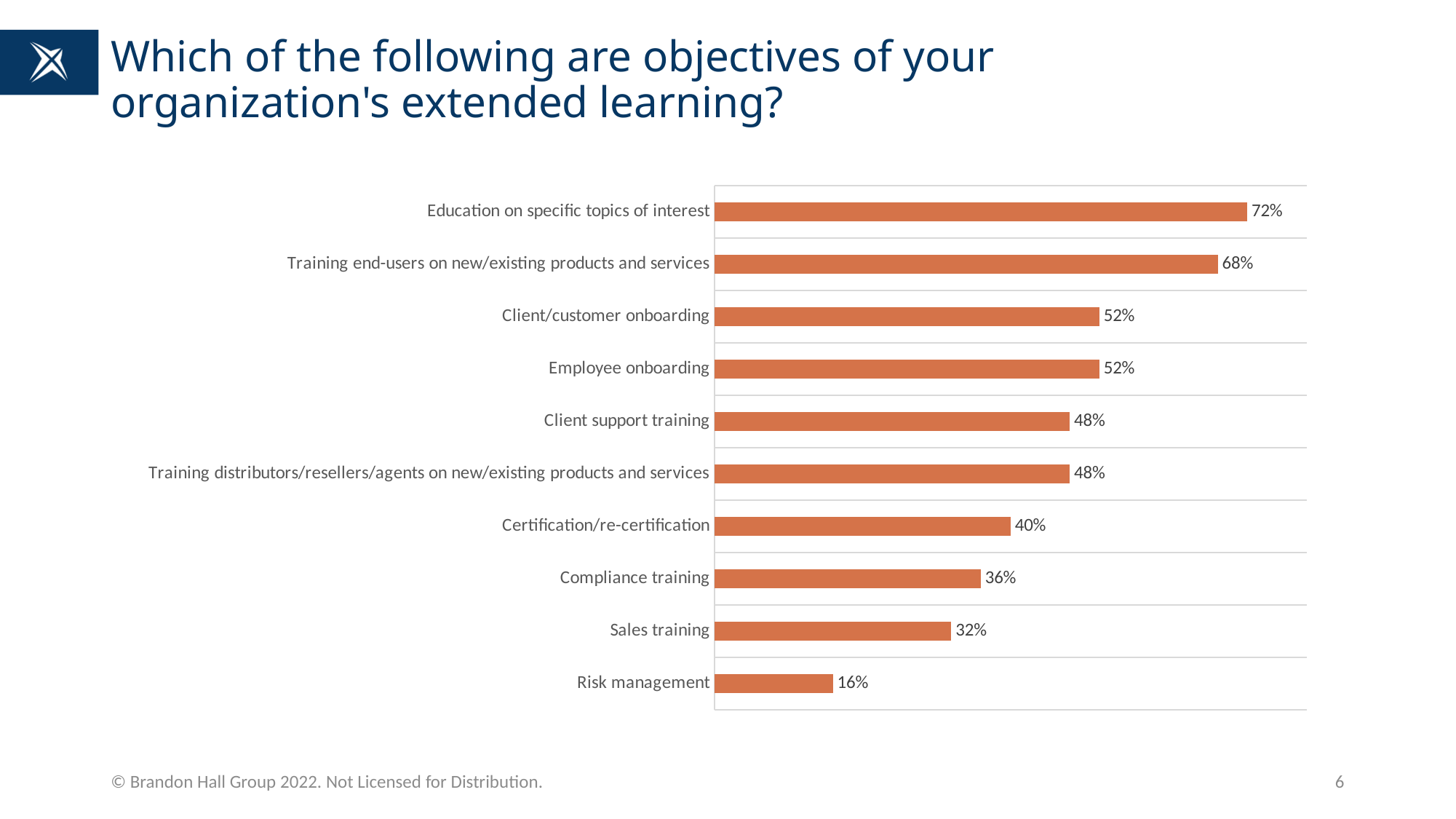
Which objective has the lowest percentage? Risk management What is the value shown for Risk management? 16% How many objectives (categories) are shown in the chart? 10 What is the difference between the values for Sales training and Risk management? 16% Which objective has the highest percentage? Education on specific topics of interest Which is larger: the value for Client support training or the value for Compliance training? Client support training What is the value for Compliance training? 36% What percentage is shown for Certification/re-certification? 40% What is the difference between the values for Education on specific topics of interest and Training end-users on new/existing products and services? 4% What percentage of respondents selected Education on specific topics of interest as an objective? 72% What kind of chart is shown on the slide? Bar chart What colour are the bars in the chart? Orange